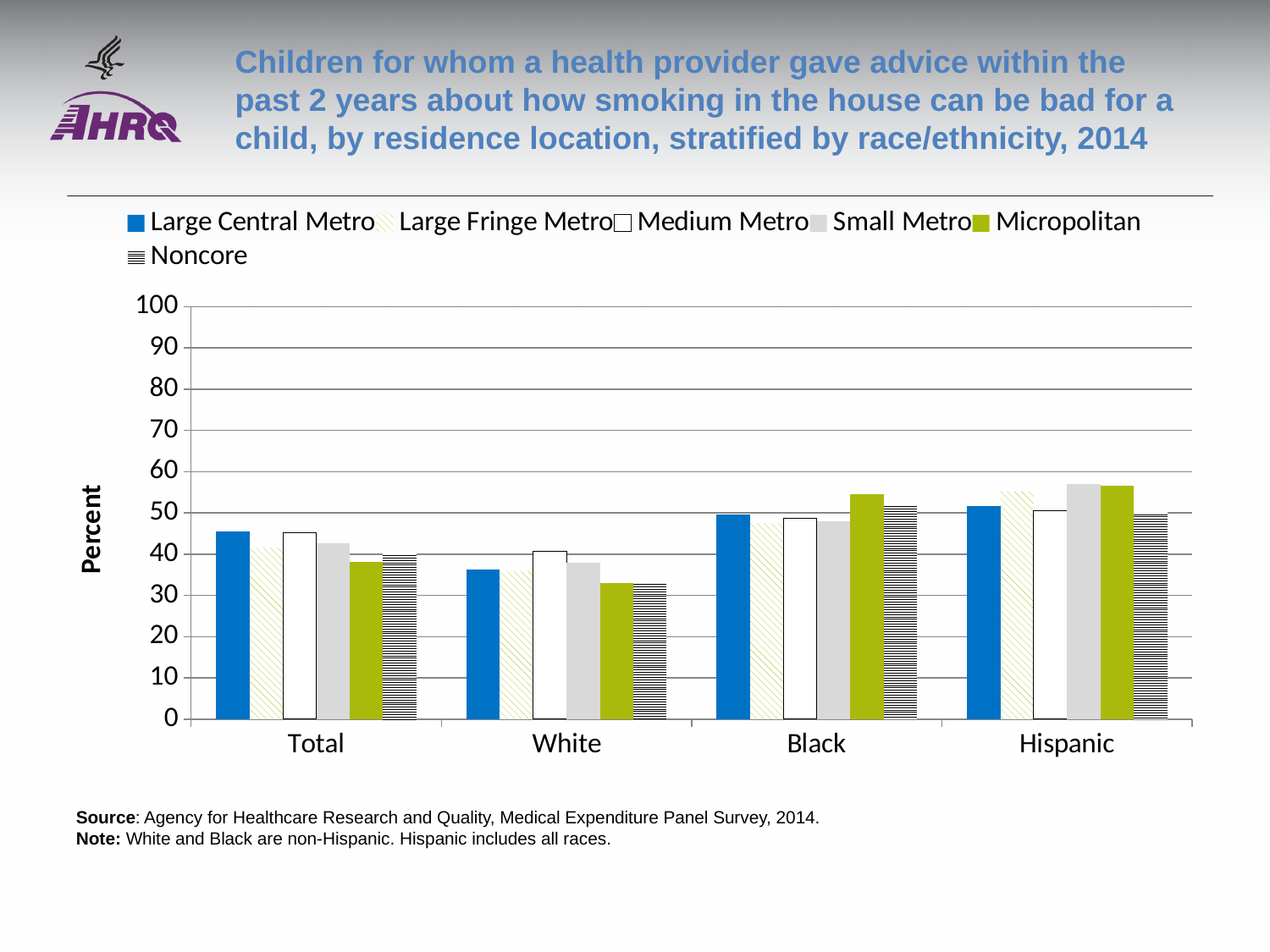
Is the Small Metro value for Hispanic greater or less than 50? greater Which is larger, the Large Central Metro value for White or the Large Central Metro value for Black? Black Which is larger, the Micropolitan value for Black or the Micropolitan value for White? Black What kind of chart is shown on the slide? bar chart How many race/ethnicity categories are shown on the x axis? 4 Which race/ethnicity category has the highest Small Metro value? Hispanic Which race/ethnicity category has the lowest Micropolitan value? White What is the label on the y axis? Percent Is the Micropolitan value for Black greater or less than 50? greater Is the Micropolitan value for White greater or less than 40? less How many series does the legend list? 6